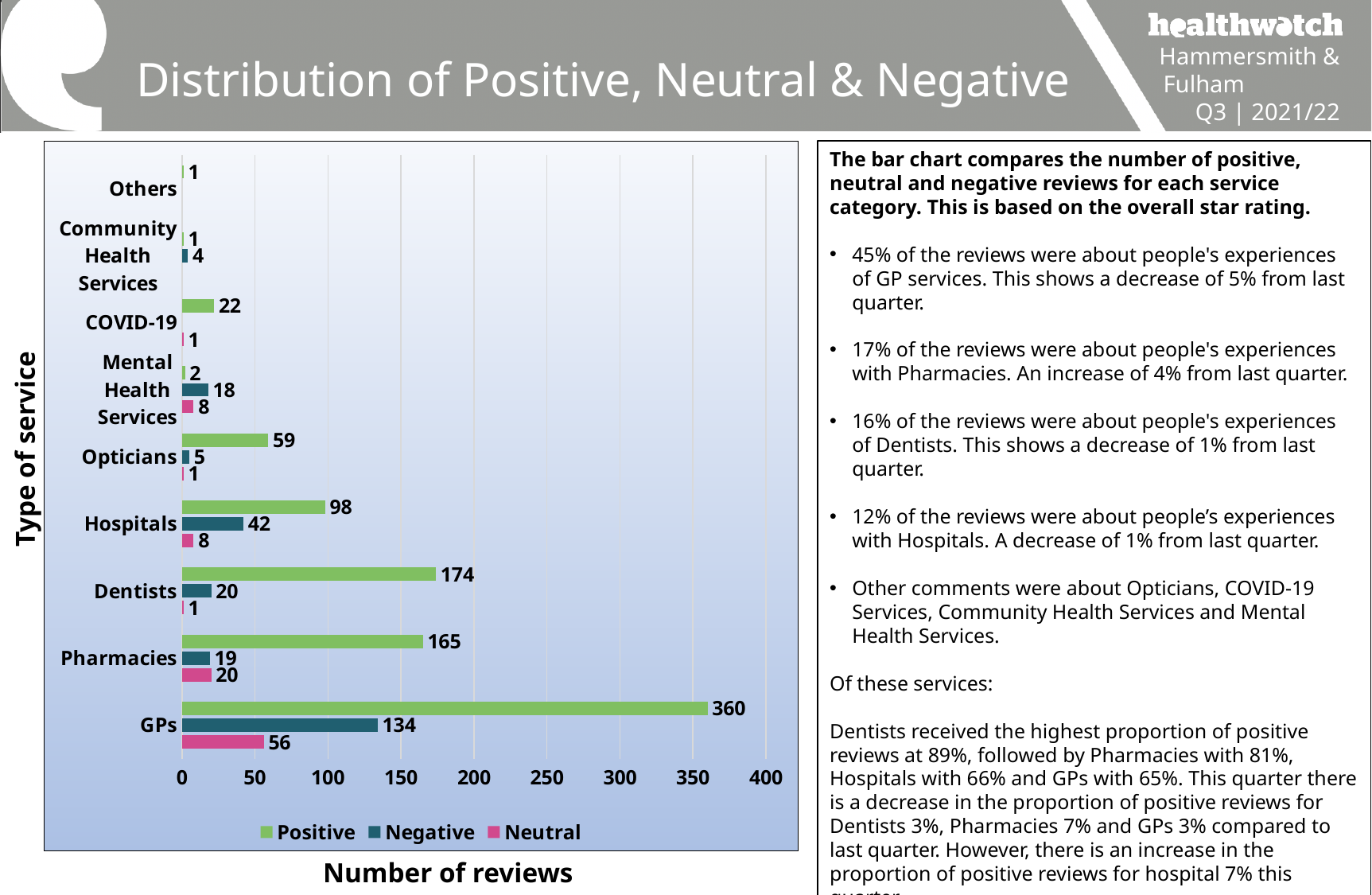
What kind of chart is shown on the slide? Bar chart Which is larger: the number of negative reviews for GPs or the number of positive reviews for Hospitals? Negative reviews for GPs Which type of service has the highest number of neutral reviews? GPs What is the difference between the positive reviews for Dentists and Pharmacies? 9 What is the number of negative reviews for Mental Health Services? 18 What is the number of positive reviews for GPs? 360 What is the number of neutral reviews for Pharmacies? 20 How many types of service are shown on the y axis? 9 What is the total number of reviews (positive, negative and neutral) for GPs? 550 What is the number of negative reviews for Hospitals? 42 How many series does the legend list? 3 Which type of service has the highest number of positive reviews? GPs